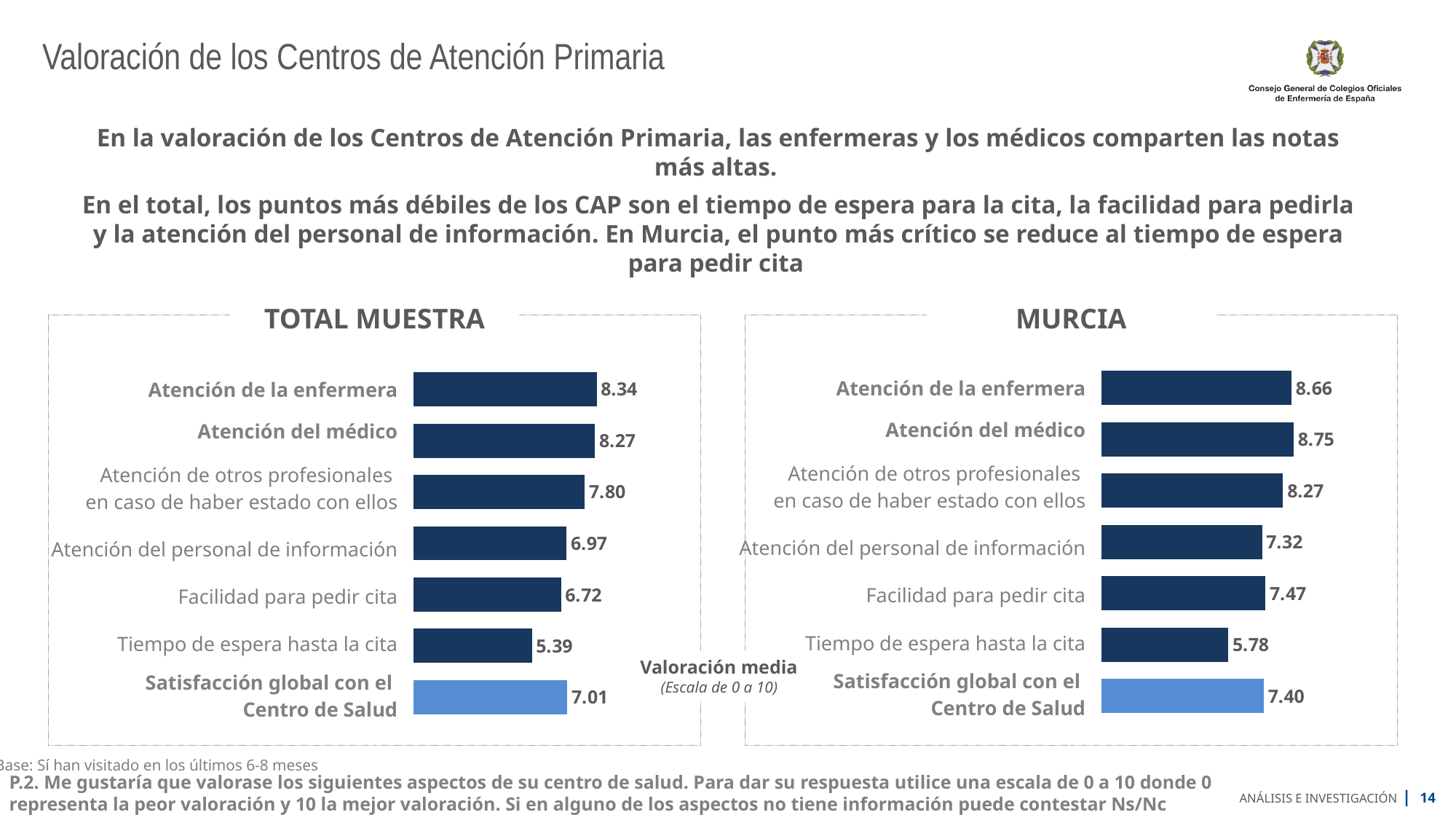
In the TOTAL MUESTRA chart, what is the value for Atención de la enfermera? 8.34 What type of chart is the TOTAL MUESTRA chart? Bar chart In the MURCIA chart, what is the value for Atención del médico? 8.75 In the TOTAL MUESTRA chart, which category has the lowest value? Tiempo de espera hasta la cita In the MURCIA chart, what is the difference between Facilidad para pedir cita and Atención del personal de información? 0.15 In the MURCIA chart, what is the value for Satisfacción global con el Centro de Salud? 7.40 Which chart has the higher value for Atención de otros profesionales en caso de haber estado con ellos, TOTAL MUESTRA or MURCIA? MURCIA In the TOTAL MUESTRA chart, what is the difference between Atención de la enfermera and Tiempo de espera hasta la cita? 2.95 In the TOTAL MUESTRA chart, which category is shown in a lighter blue colour than the others? Satisfacción global con el Centro de Salud In the TOTAL MUESTRA chart, which is larger: Atención del personal de información or Facilidad para pedir cita? Atención del personal de información In the MURCIA chart, which category has the highest value? Atención del médico How many categories are shown in the MURCIA chart? 7